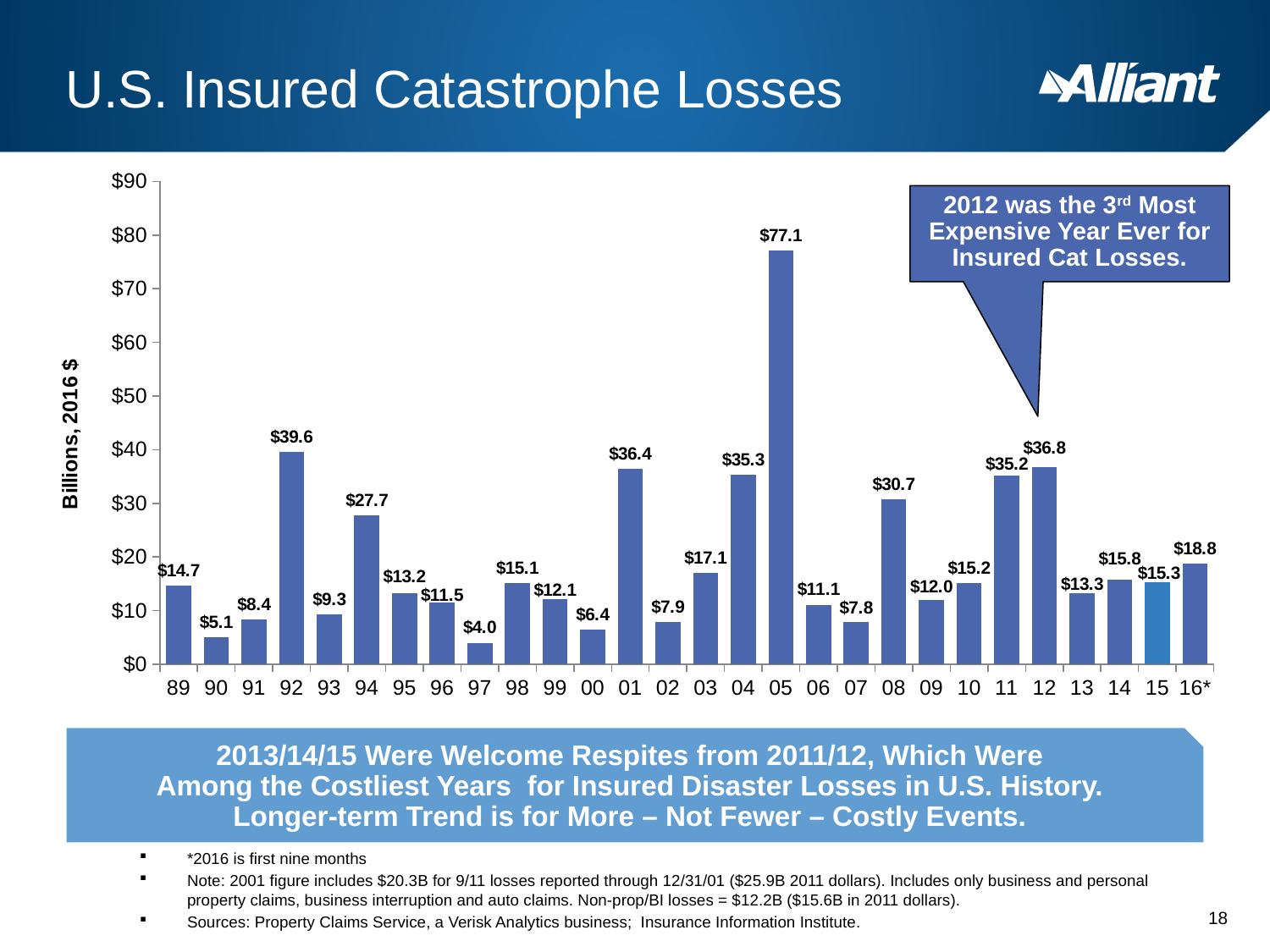
What is the difference between the values for 2005 (05) and 2012 (12)? $40.3 Which is larger, the value for 1992 (92) or the value for 2001 (01)? 92 What kind of chart is shown on the slide? Bar chart What is the value for 2005 (05)? $77.1 What is the value for 2012 (12)? $36.8 What is the value for 2016 (16*)? $18.8 What is the value for 1992 (92)? $39.6 How many years (bars) are shown on the chart? 28 Is the value for 2008 (08) greater or less than $20? greater Which year has the lowest insured catastrophe losses? 97 What is the label on the vertical axis of the chart? Billions, 2016 $ Which year has the highest insured catastrophe losses? 05